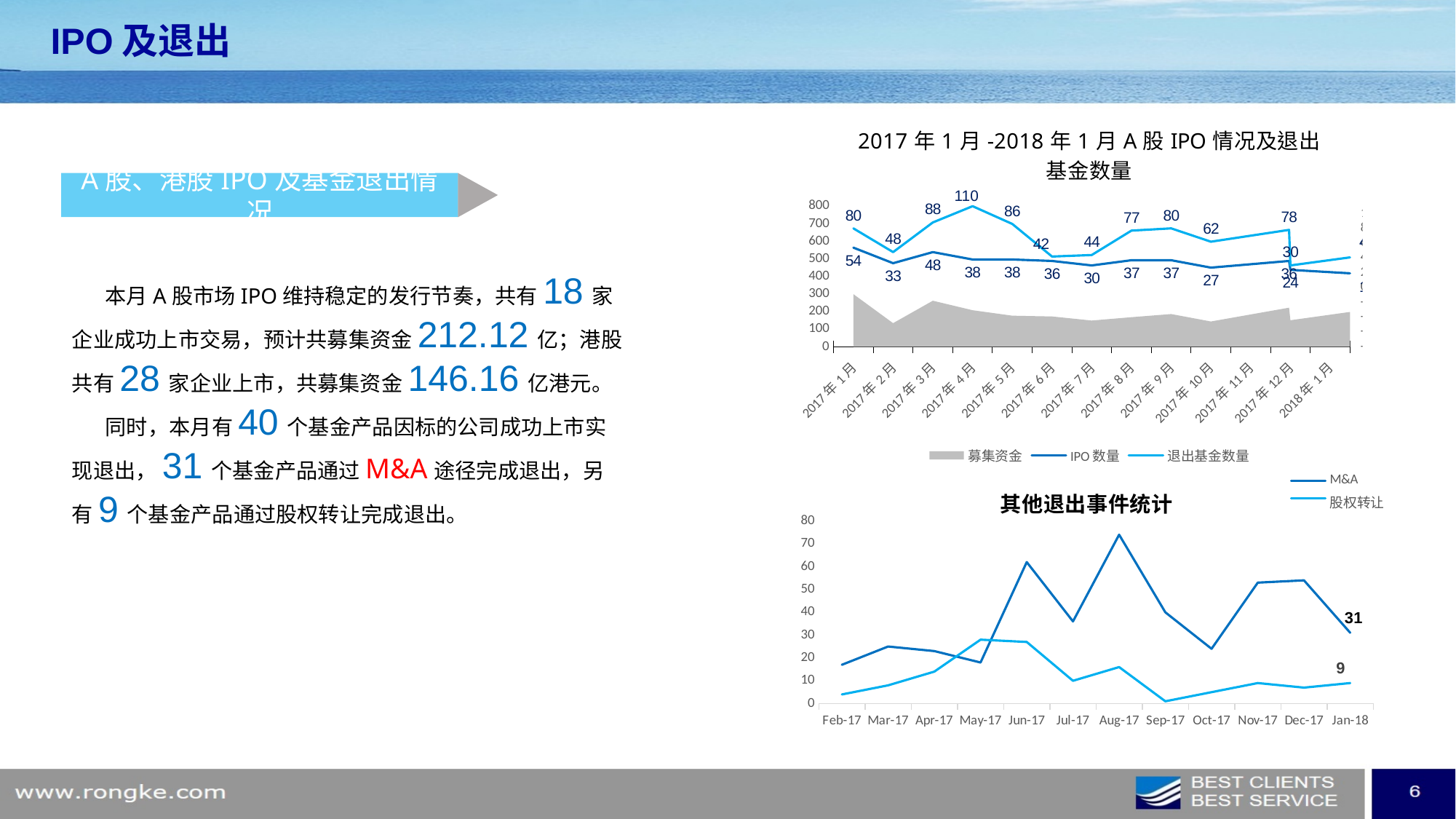
In the top chart (2017年1月-2018年1月A股IPO情况及退出基金数量), what is the 退出基金数量 value for 2017年4月? 110 In the top chart, what is the difference between the 退出基金数量 values for 2017年3月 and 2017年2月? 40 How many months are shown on the x axis of the bottom chart (其他退出事件统计)? 12 In the top chart, what is the IPO数量 value for 2017年10月? 27 In the bottom chart (其他退出事件统计), in which month does the M&A series reach its highest value? Aug-17 In the top chart, which is larger: the 退出基金数量 for 2017年8月 or for 2017年6月? 2017年8月 In the bottom chart (其他退出事件统计), what is the 股权转让 value for Jan-18? 9 How many series does the legend of the top chart list? 3 In the top chart, what is the IPO数量 value for 2017年1月? 54 In the bottom chart (其他退出事件统计), is the M&A value for Jun-17 greater or less than 50? greater In the bottom chart (其他退出事件统计), what is the M&A value for Jan-18? 31 In the top chart, which month has the highest 退出基金数量? 2017年4月